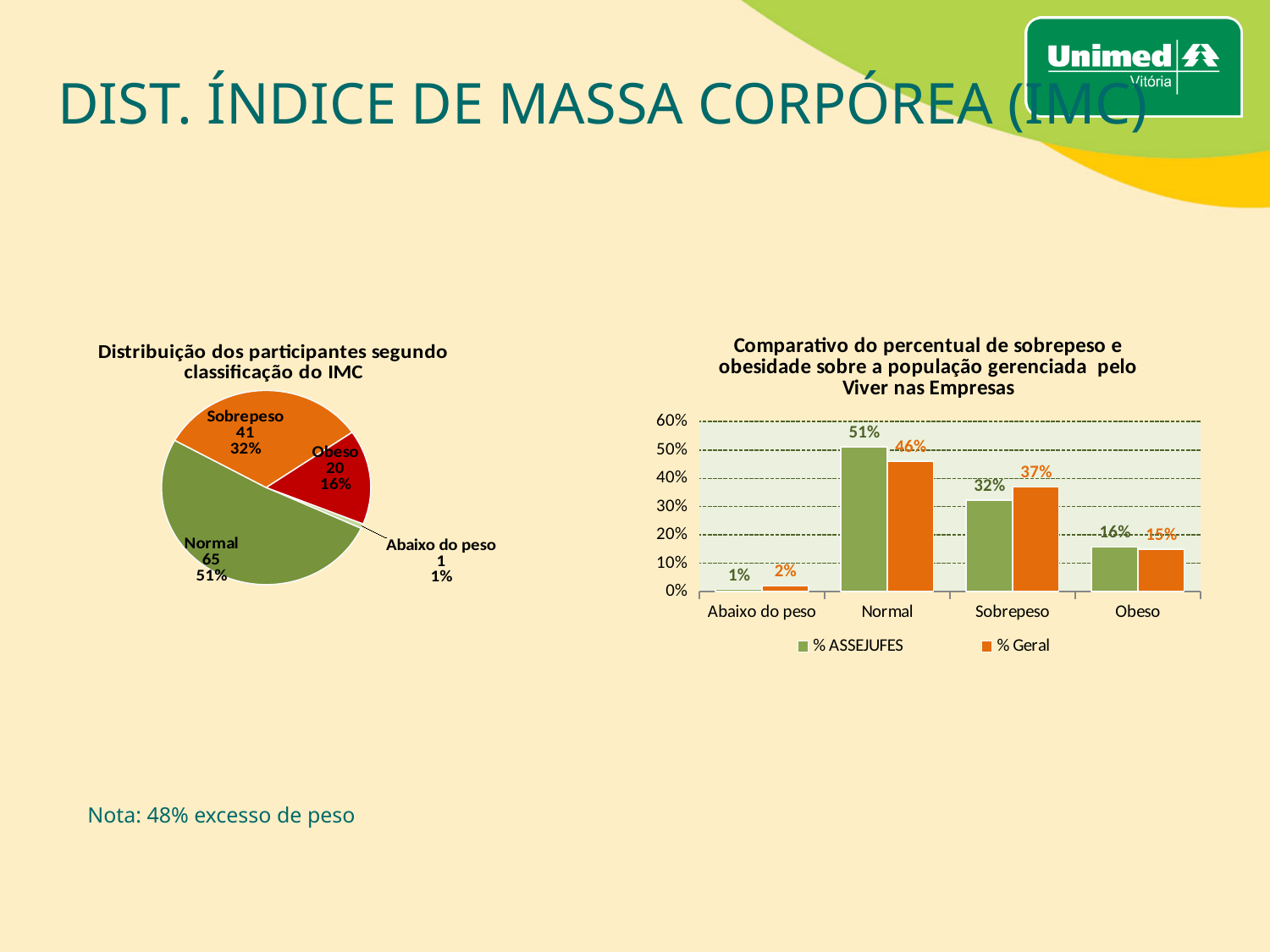
In the bar chart on the right, how many series does the legend list? 2 What type of chart is the chart on the right of the slide? Bar chart In the pie chart on the left, which IMC category has the smallest share of participants? Abaixo do peso In the pie chart on the left, how many categories are shown? 4 In the bar chart on the right, what is the difference between % Geral and % ASSEJUFES for Sobrepeso? 5% In the bar chart on the right, what is the % ASSEJUFES value for Normal? 51% In the pie chart on the left, how many participants are classified as Normal? 65 In the bar chart on the right, which is larger for Obeso: % ASSEJUFES or % Geral? % ASSEJUFES In the pie chart on the left, how many more participants are Sobrepeso than Obeso? 21 In the pie chart on the left, what percentage of participants are classified as Sobrepeso? 32% In the pie chart on the left, which IMC category has the largest share of participants? Normal In the bar chart on the right, what is the % Geral value for Sobrepeso? 37%